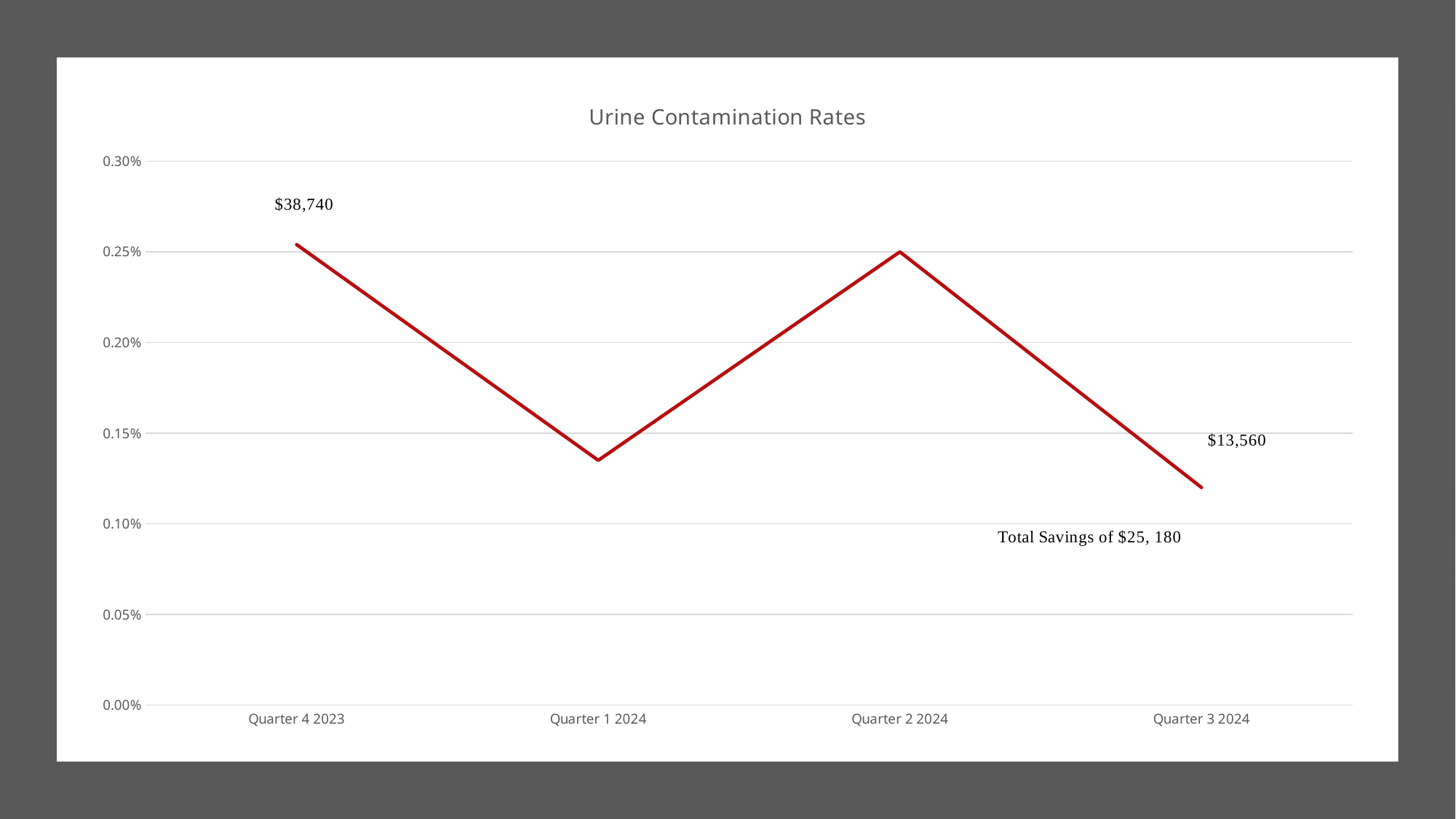
Is the value for Quarter 3 2024 greater or less than 0.15%? less Which quarter has the highest urine contamination rate? Quarter 4 2023 What total savings amount is annotated on the chart? $25, 180 Is the value for Quarter 2 2024 greater or less than 0.20%? greater Which quarter has the lowest urine contamination rate? Quarter 3 2024 What kind of chart is shown on the slide? line chart Which is larger, the value for Quarter 1 2024 or the value for Quarter 2 2024? Quarter 2 2024 What is the title of the chart? Urine Contamination Rates Is the value for Quarter 4 2023 greater or less than 0.20%? greater How many quarters are plotted on the x axis? 4 Does the contamination rate rise or fall from Quarter 2 2024 to Quarter 3 2024? fall